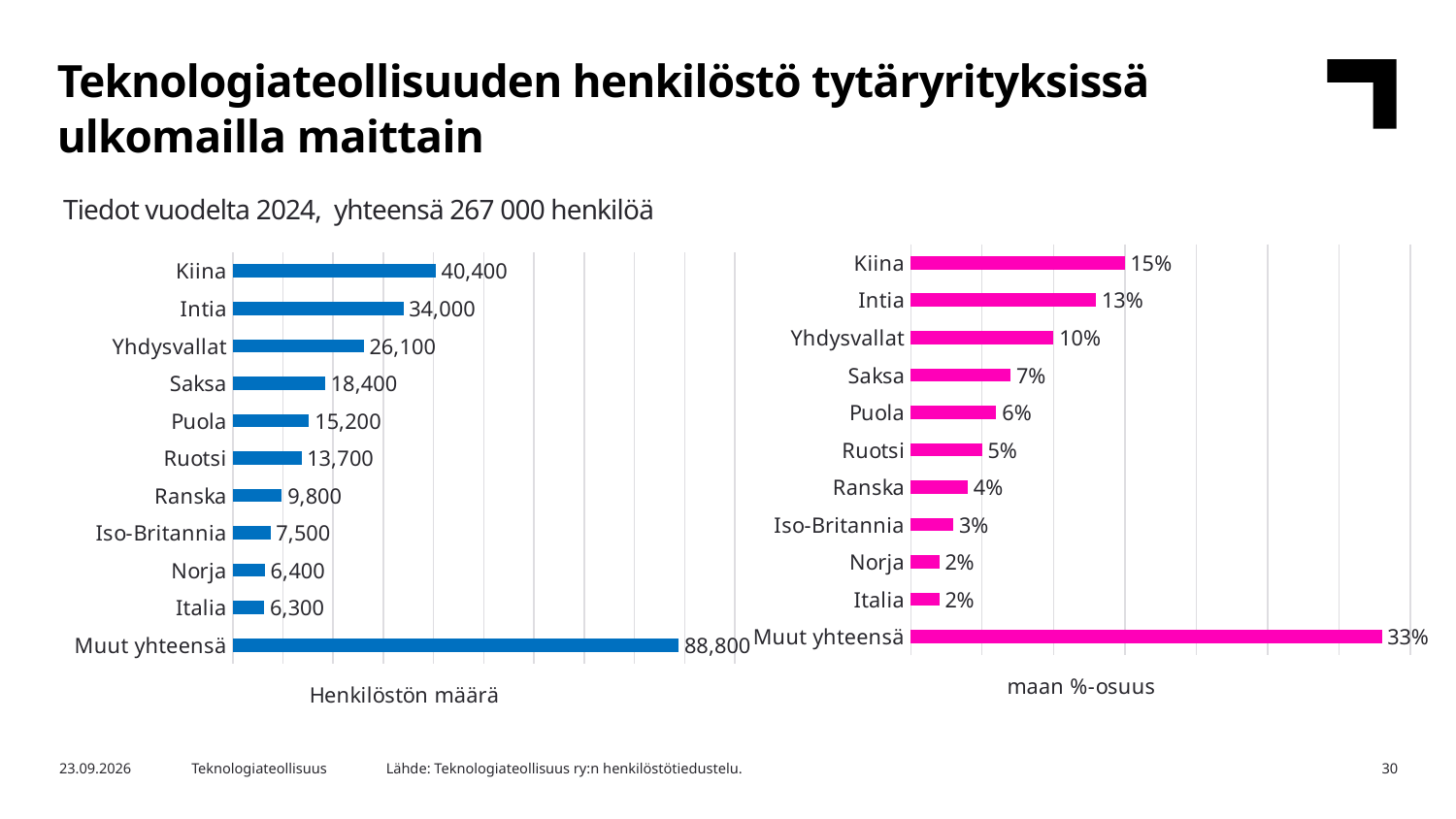
In the right chart (maan %-osuus), what is the share shown for Yhdysvallat? 10% In the left chart (Henkilöstön määrä), which category has the highest value? Muut yhteensä In the left chart (Henkilöstön määrä), which category has the lowest value? Italia In the left chart (Henkilöstön määrä), what is the value for Kiina? 40,400 What type of chart is the right chart (maan %-osuus)? Bar chart In the left chart (Henkilöstön määrä), which is larger, the value for Puola or the value for Ranska? Puola In the right chart (maan %-osuus), what is the difference between the shares for Kiina and Saksa? 8 percentage points In the right chart (maan %-osuus), what is the share shown for Muut yhteensä? 33% What colour are the bars in the right chart (maan %-osuus)? Magenta (pink) In the left chart (Henkilöstön määrä), what is the value for Ruotsi? 13,700 In the left chart (Henkilöstön määrä), what is the difference between the values for Kiina and Intia? 6,400 How many categories are shown in the left chart (Henkilöstön määrä)? 11